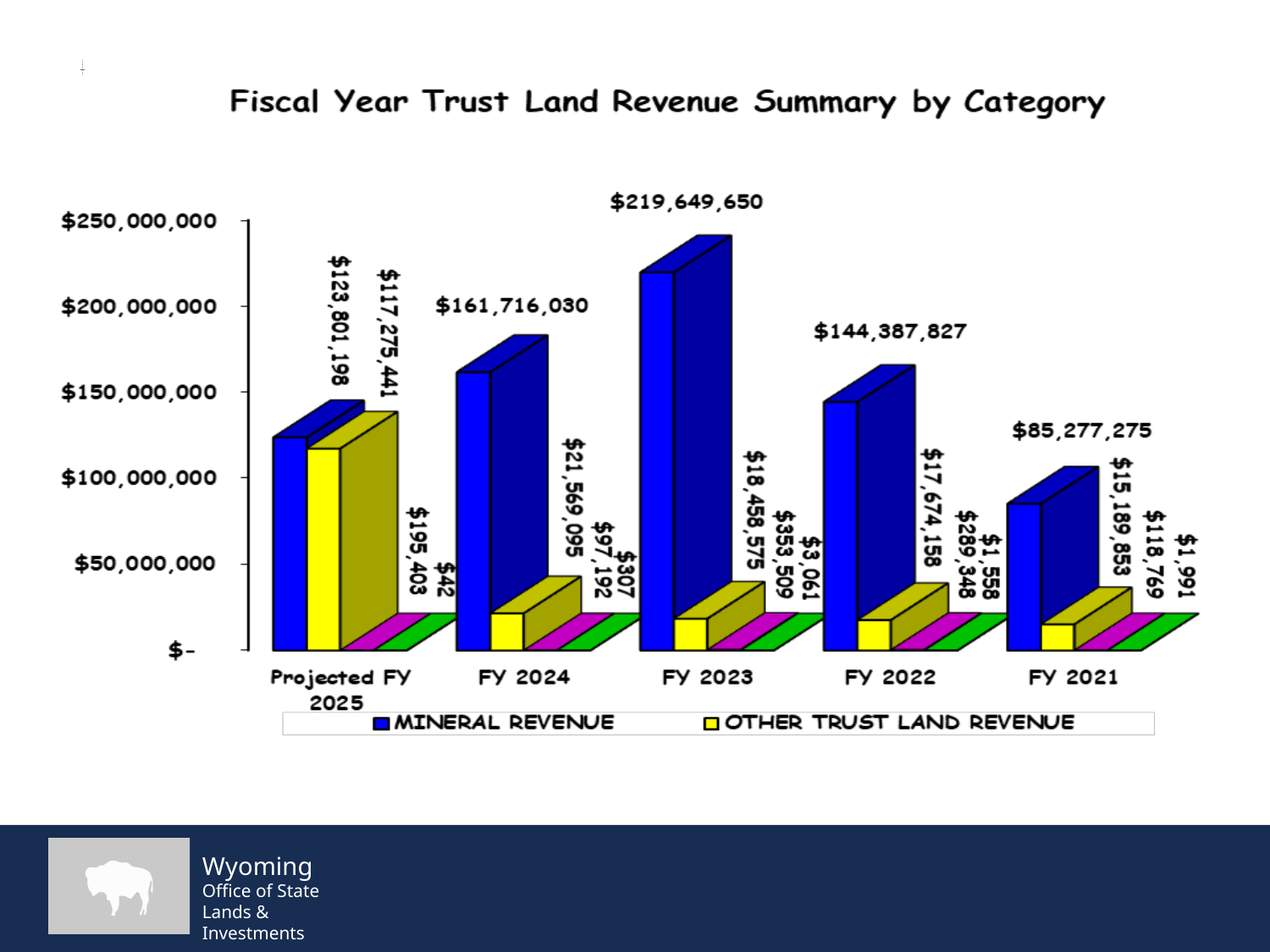
How many series does the legend list? 2 Which fiscal year has the highest Mineral Revenue? FY 2023 How many fiscal year categories are shown on the x axis? 5 Does the Other Trust Land Revenue rise or fall moving from left to right along the x axis? fall Which is larger: Other Trust Land Revenue for FY 2024 or for FY 2022? FY 2024 What is the difference between the Mineral Revenue for FY 2023 and FY 2024? $57,933,620 Is the Mineral Revenue for FY 2022 greater or less than $100,000,000? greater What is the Other Trust Land Revenue value for Projected FY 2025? $117,275,441 What kind of chart is shown on the slide? bar chart What is the Mineral Revenue value for FY 2021? $85,277,275 Which fiscal year has the lowest Other Trust Land Revenue? FY 2021 What is the Mineral Revenue value for FY 2023? $219,649,650